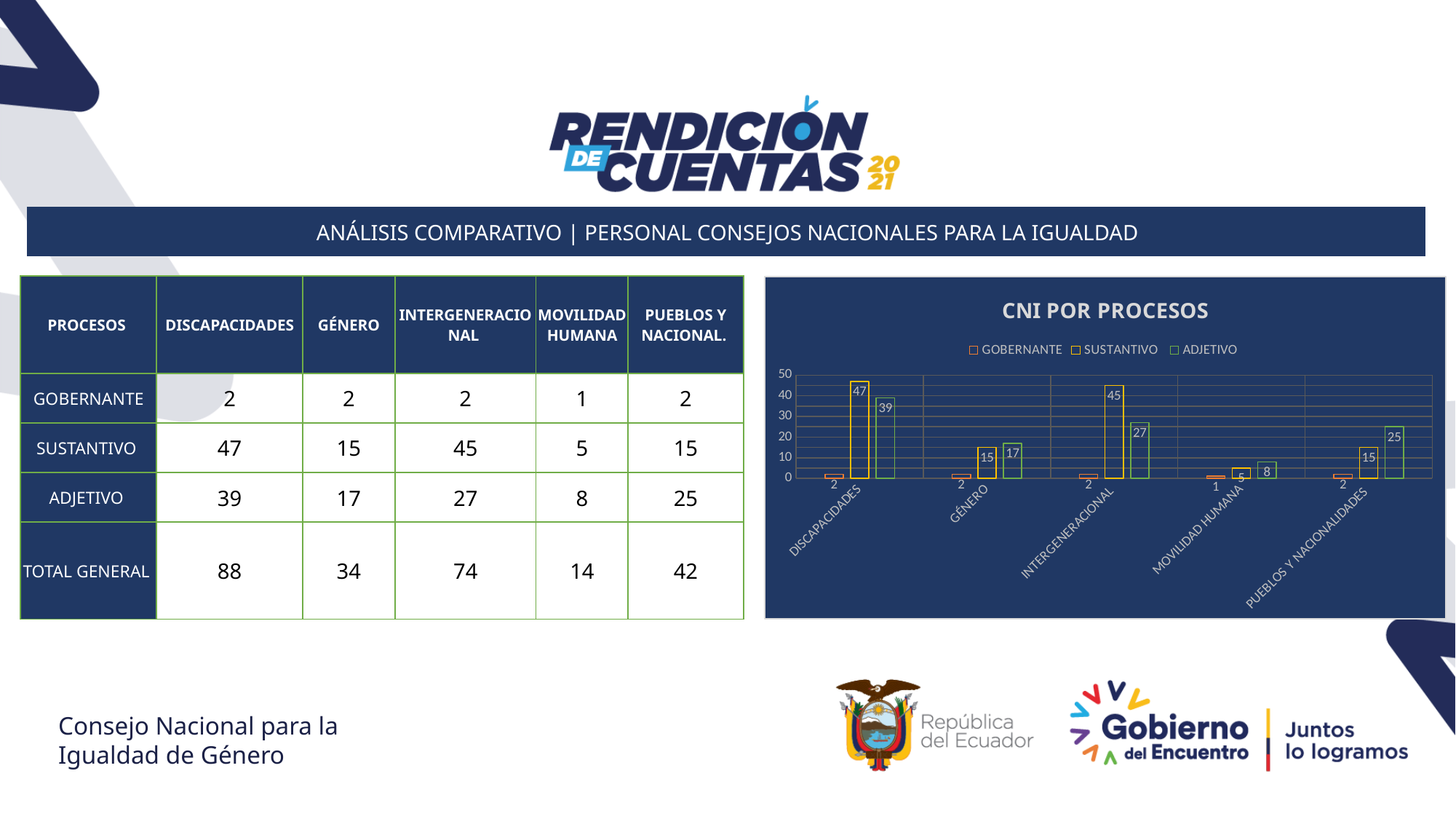
In the "CNI POR PROCESOS" chart, what is the difference between the SUSTANTIVO and ADJETIVO values for DISCAPACIDADES? 8 How many series does the legend of the "CNI POR PROCESOS" chart list? 3 What type of chart is "CNI POR PROCESOS"? bar chart How many categories are shown on the x axis of the "CNI POR PROCESOS" chart? 5 In the "CNI POR PROCESOS" chart, which is larger for GÉNERO: the SUSTANTIVO value or the ADJETIVO value? ADJETIVO In the "CNI POR PROCESOS" chart, what is the ADJETIVO value for INTERGENERACIONAL? 27 In the "CNI POR PROCESOS" chart, what is the GOBERNANTE value for MOVILIDAD HUMANA? 1 In the "CNI POR PROCESOS" chart, which category has the lowest ADJETIVO value? MOVILIDAD HUMANA In the "CNI POR PROCESOS" chart, which category has the highest SUSTANTIVO value? DISCAPACIDADES What is the title of the chart on the slide? CNI POR PROCESOS In the "CNI POR PROCESOS" chart, what is the SUSTANTIVO value for DISCAPACIDADES? 47 In the "CNI POR PROCESOS" chart, is the SUSTANTIVO value for INTERGENERACIONAL greater or less than 40? greater